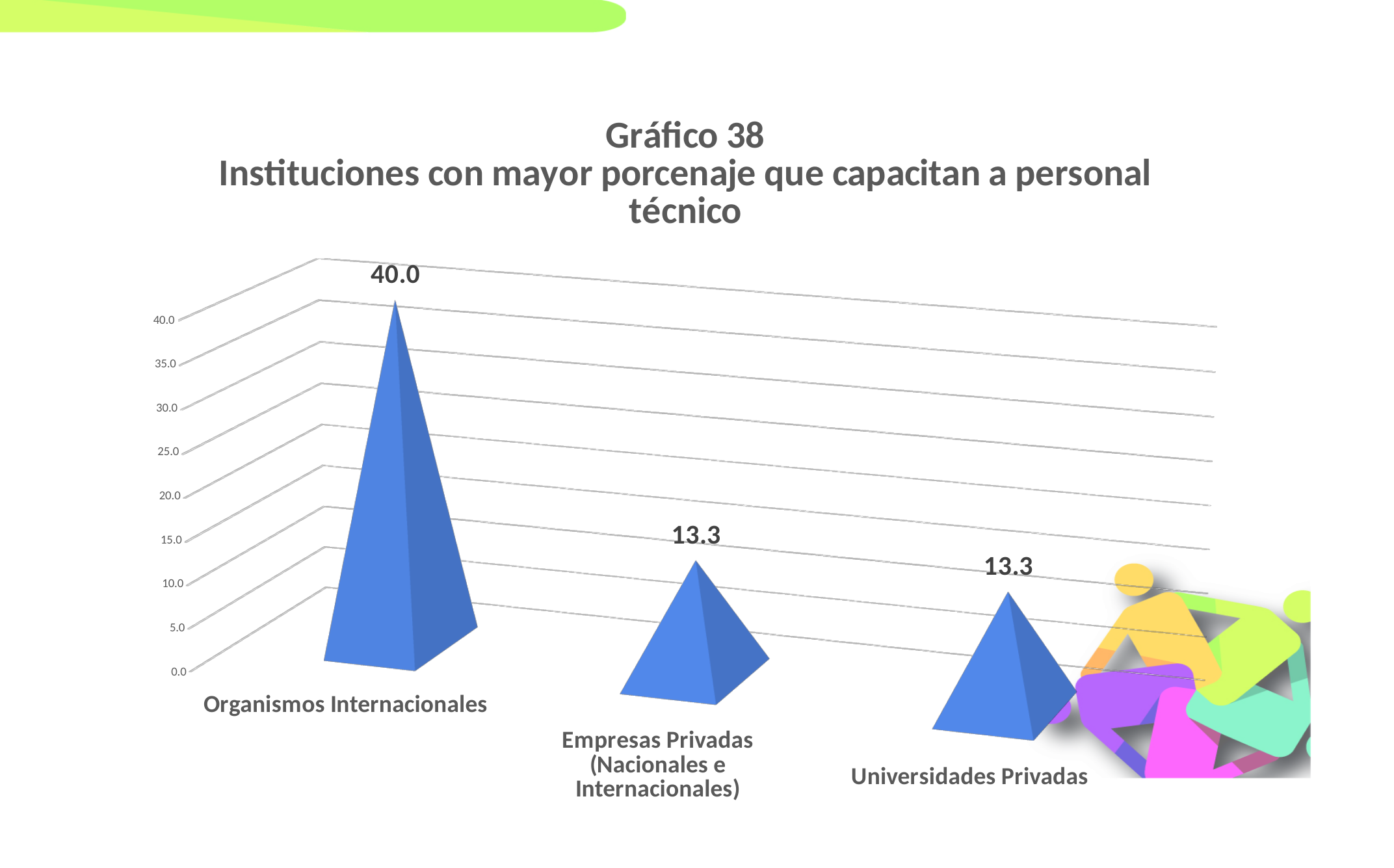
What is the title of the chart? Gráfico 38 Instituciones con mayor porcenaje que capacitan a personal técnico What kind of chart is this? bar chart Is the value for Universidades Privadas greater or less than 20.0? less Which category has the highest value? Organismos Internacionales Which is larger, the value for Organismos Internacionales or the value for Empresas Privadas (Nacionales e Internacionales)? Organismos Internacionales What is the value for Universidades Privadas? 13.3 What is the value for Empresas Privadas (Nacionales e Internacionales)? 13.3 How many categories are shown in the chart? 3 What is the difference between the values for Organismos Internacionales and Universidades Privadas? 26.7 Is the value for Organismos Internacionales greater or less than 30.0? greater What is the highest value shown on the vertical axis? 40.0 What is the value for Organismos Internacionales? 40.0